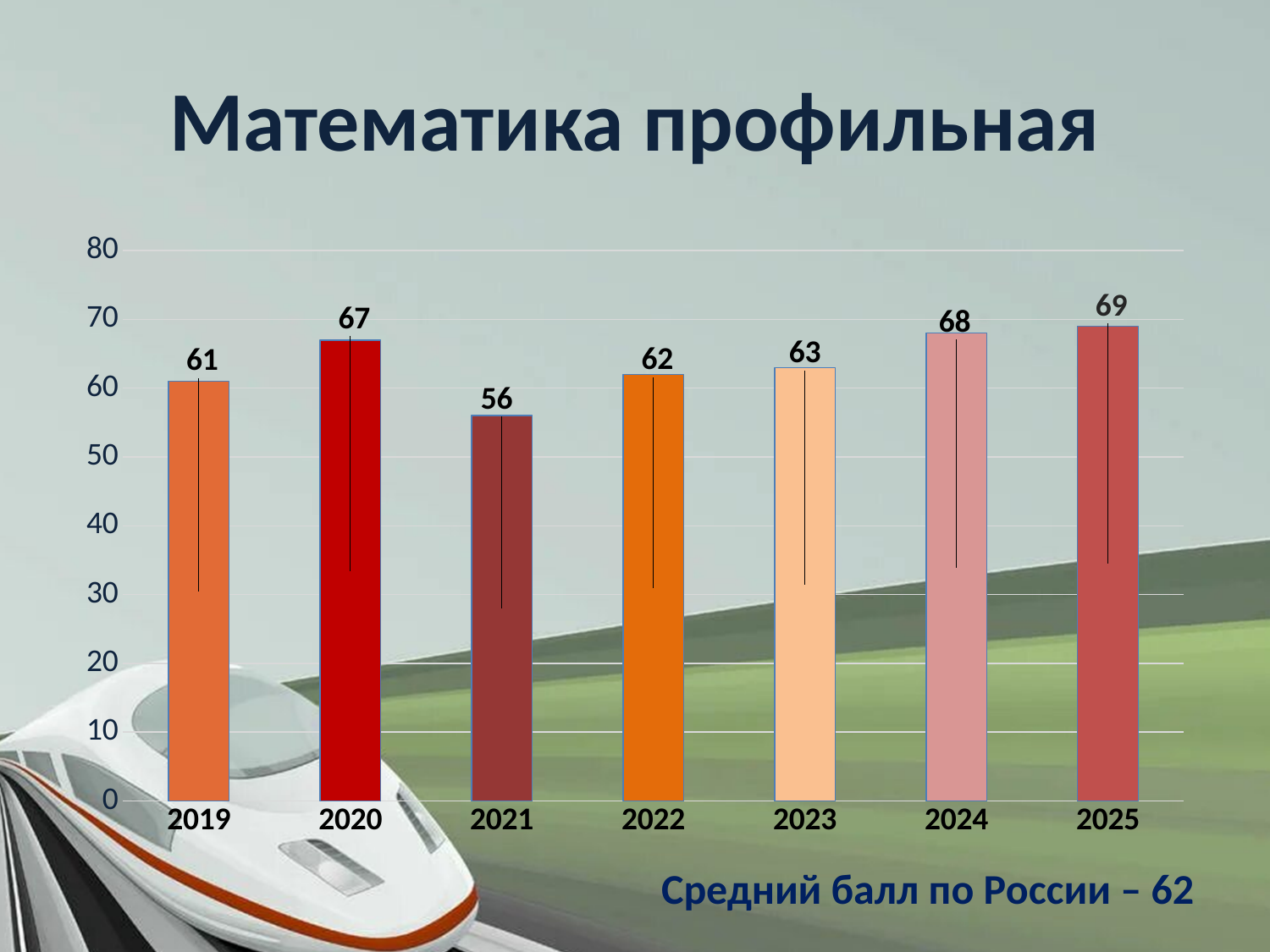
What is the difference between the values for 2025 and 2021? 13 What is the value for 2024? 68 What is the difference between the values for 2020 and 2019? 6 Which year has the lowest value? 2021 How many years are shown on the chart? 7 What is the value for 2019? 61 Which is larger, the value for 2022 or the value for 2023? 2023 What is the value for 2021? 56 Which year has the highest value? 2025 What kind of chart is shown on the slide? bar chart Is the value for 2020 greater or less than 60? greater What is the title of the slide? Математика профильная